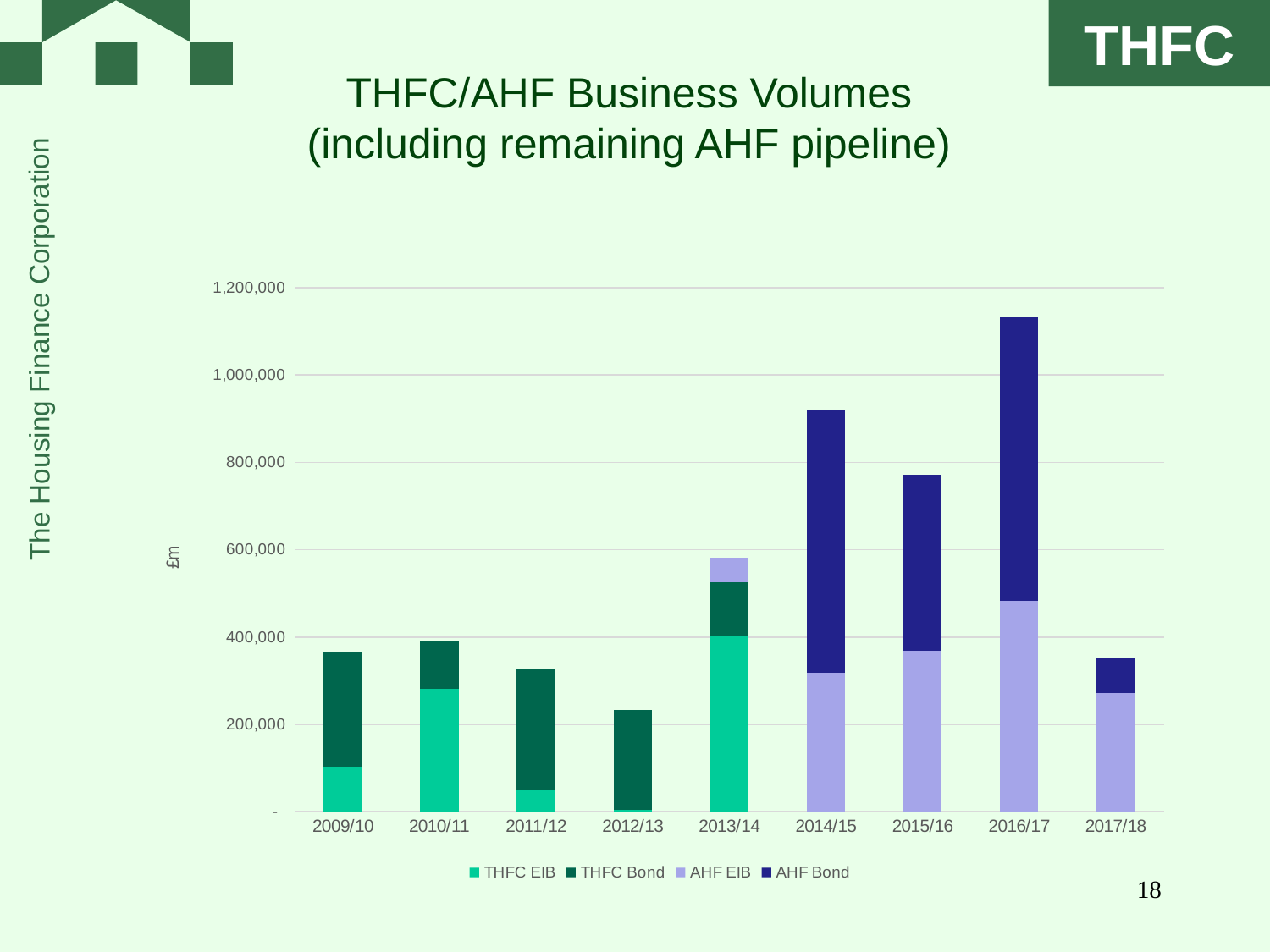
Which year has the tallest stacked bar in the chart? 2016/17 Is the total value for 2014/15 greater or less than 800,000? greater What kind of chart is shown on the slide? Stacked bar chart Is the total value for 2017/18 greater or less than 400,000? less Which year has the shortest stacked bar in the chart? 2012/13 How many financial years are shown on the x axis of the chart? 9 Is the total value for 2012/13 greater or less than 400,000? less How many series does the chart legend list? 4 Which year has the larger total bar, 2010/11 or 2012/13? 2010/11 Which year has the larger total bar, 2014/15 or 2015/16? 2014/15 What is the label on the vertical axis of the chart? £m